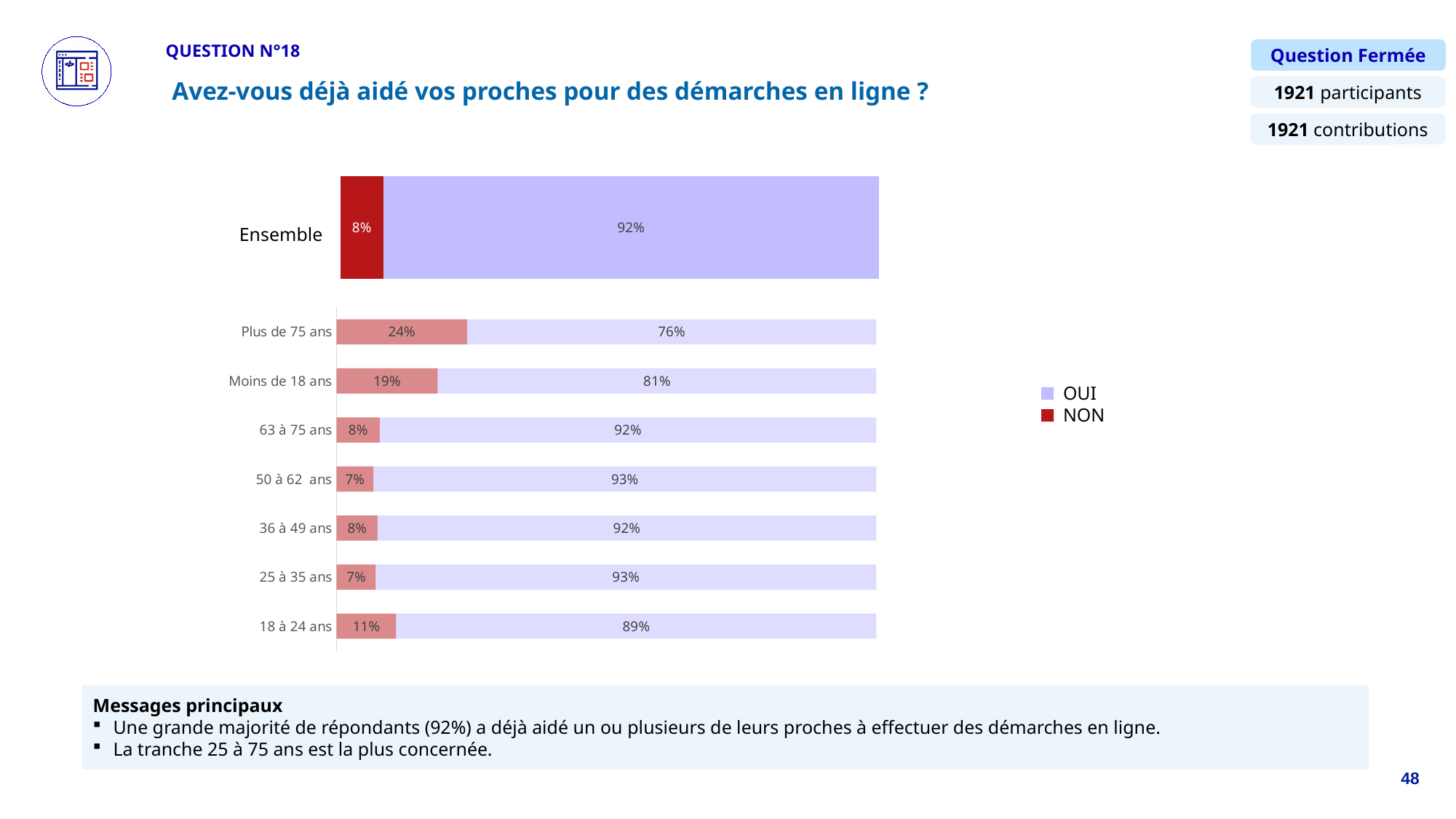
In the top chart (Ensemble), what percentage of respondents answered OUI? 92% In the lower chart by age group, which age group has the highest NON share? Plus de 75 ans How many series does the legend list? 2 In the lower chart by age group, what is the difference between the OUI values for '50 à 62 ans' and 'Plus de 75 ans'? 17% In the lower chart by age group, what is the NON value for 'Moins de 18 ans'? 19% How many age groups are shown in the lower chart? 7 In the lower chart by age group, what is the NON value for '18 à 24 ans'? 11% In the top chart (Ensemble), what percentage of respondents answered NON? 8% In the lower chart by age group, which has a larger NON share: 'Moins de 18 ans' or '18 à 24 ans'? Moins de 18 ans In the lower chart by age group, what is the OUI value for 'Plus de 75 ans'? 76% What type of chart is used to show the results by age group? Stacked bar chart In the lower chart by age group, which age group has the lowest OUI share? Plus de 75 ans